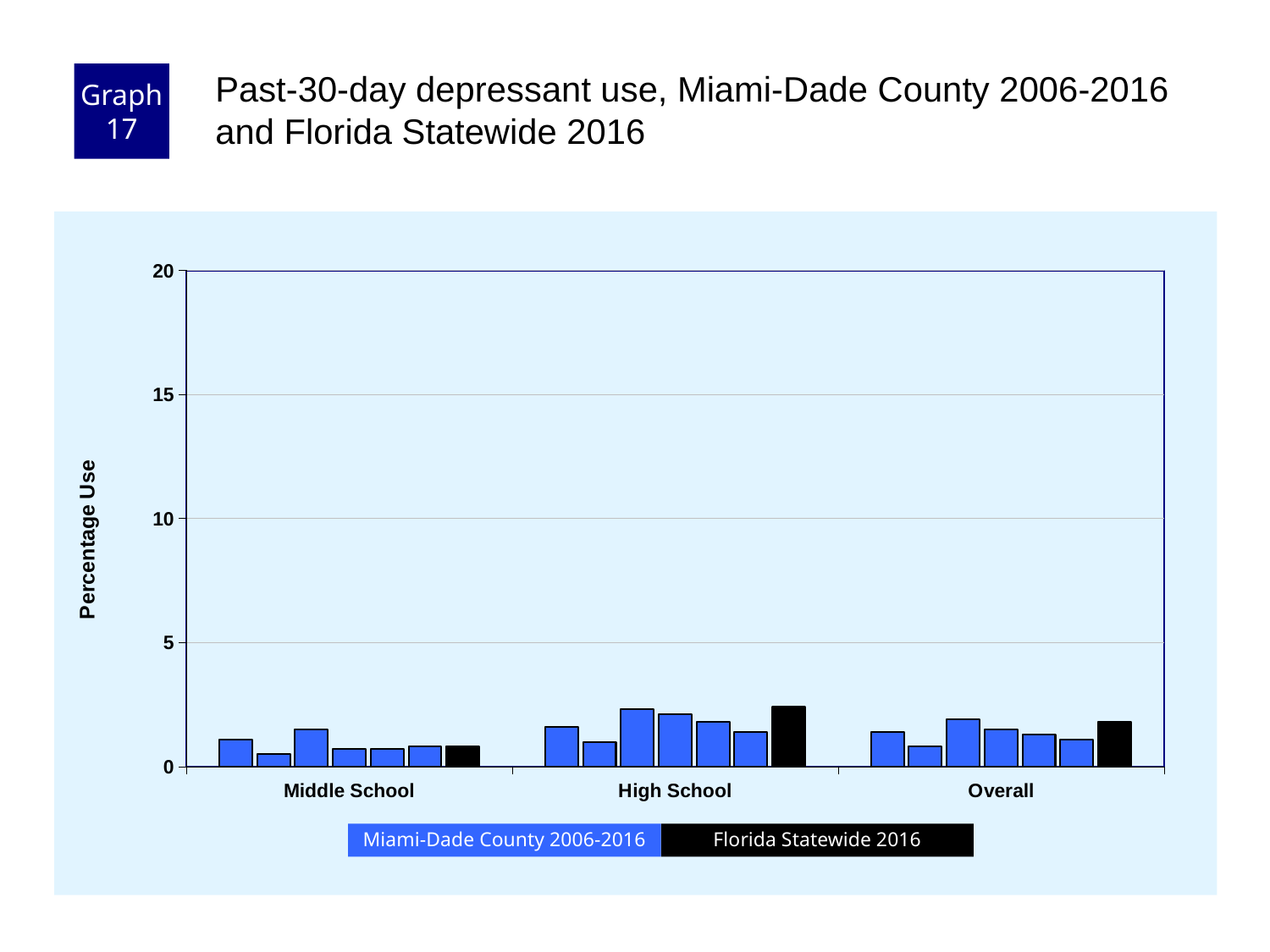
Is the Florida Statewide 2016 value for High School greater or less than 5? less Which is larger, the Florida Statewide 2016 value for High School or for Middle School? High School What is the title of the chart? Past-30-day depressant use, Miami-Dade County 2006-2016 and Florida Statewide 2016 What kind of chart is shown on the slide? bar chart What is the label on the y axis? Percentage Use How many categories are shown on the x axis? 3 Is the Florida Statewide 2016 value for Middle School greater or less than 5? less How many series does the legend list? 2 Is the Florida Statewide 2016 value for Overall greater or less than 10? less Which category has the highest Florida Statewide 2016 value? High School How many bars are plotted in the Middle School group? 7 Which category has the lowest Florida Statewide 2016 value? Middle School